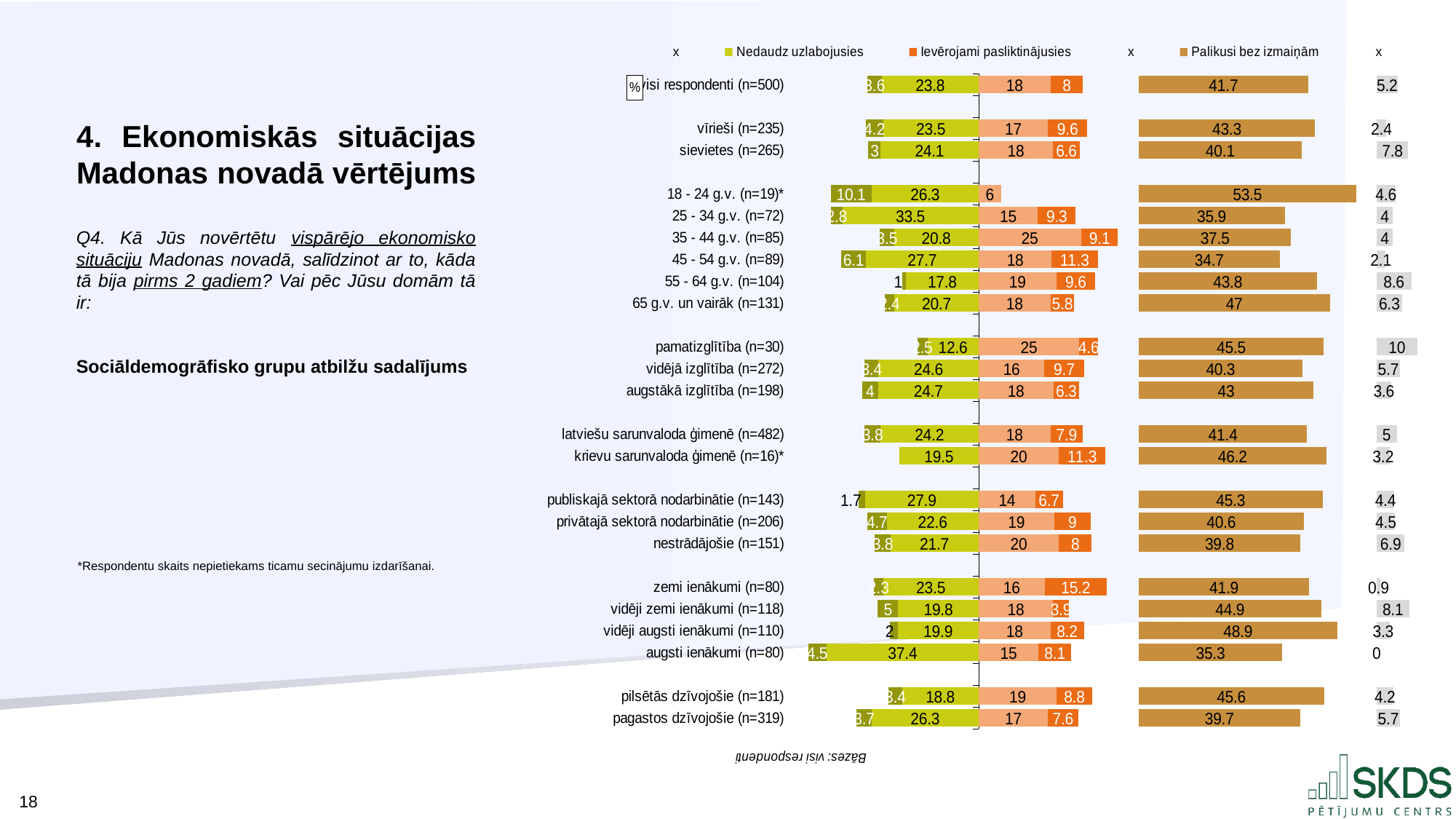
Which group has the highest value for "Ievērojami pasliktinājusies"? zemi ienākumi (n=80) How many respondent groups are shown in the chart? 23 Which group has the highest value for "Palikusi bez izmaiņām"? 18 - 24 g.v. (n=19)* What kind of chart is shown on the slide? Stacked bar chart What is the difference in "Palikusi bez izmaiņām" between vīrieši (n=235) and sievietes (n=265)? 3.2 Which has a larger "Nedaudz uzlabojusies" value: 25 - 34 g.v. (n=72) or 35 - 44 g.v. (n=85)? 25 - 34 g.v. (n=72) How many named series does the legend list? 3 What is the value of "Ievērojami pasliktinājusies" for krievu sarunvaloda ģimenē (n=16)*? 11.3 Which group has the lowest value for "Nedaudz uzlabojusies"? pamatizglītība (n=30) What is the value of "Nedaudz uzlabojusies" for augsti ienākumi (n=80)? 37.4 What is the difference in "Nedaudz uzlabojusies" between pagastos dzīvojošie (n=319) and pilsētās dzīvojošie (n=181)? 7.5 What is the value of "Palikusi bez izmaiņām" for visi respondenti (n=500)? 41.7